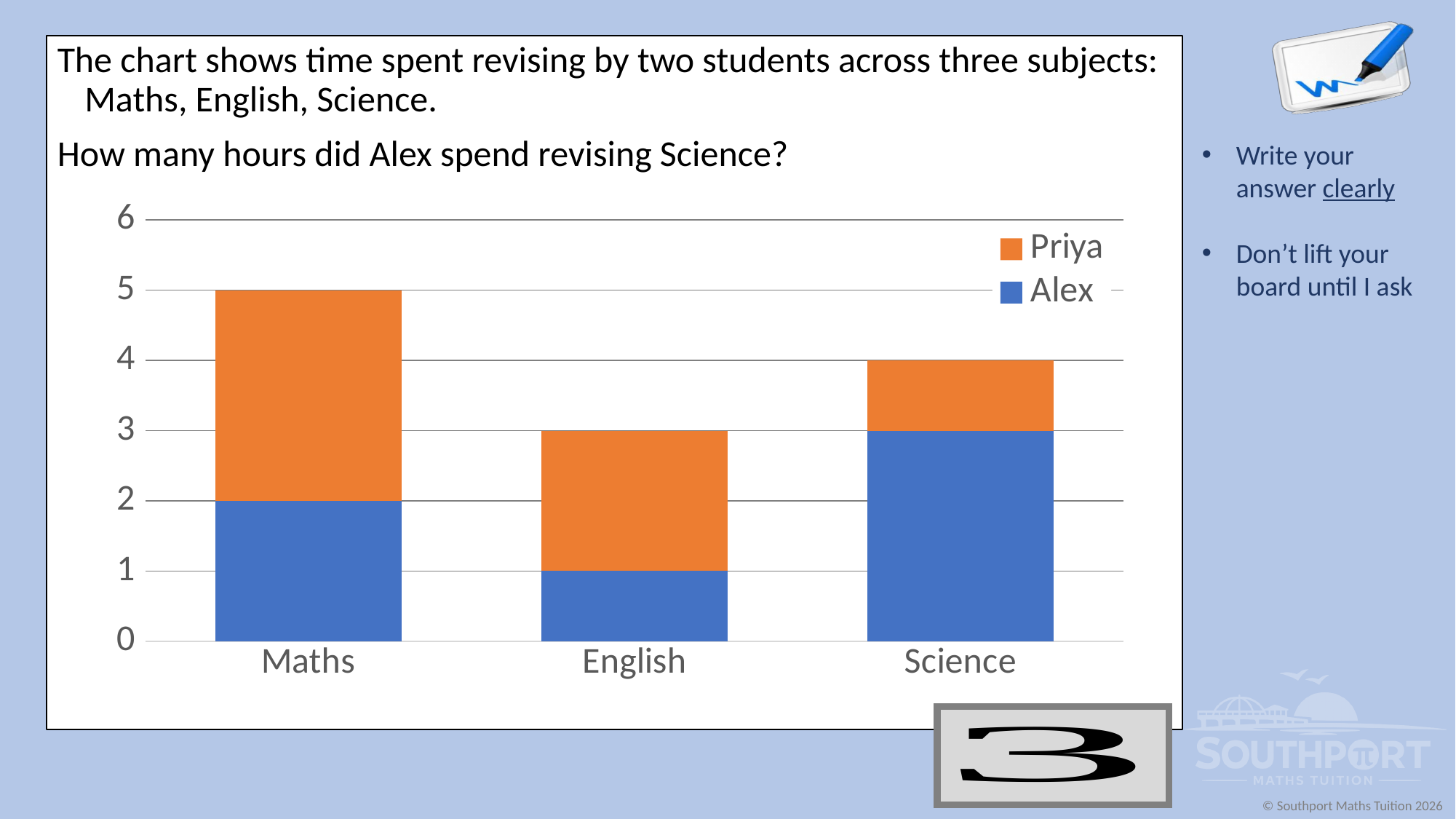
How many hours did Alex spend revising Science? 3 How many hours did Priya spend revising Maths? 3 What kind of chart is shown on the slide? stacked bar chart What is the total height of the stacked bar for English? 3 How many series does the legend list? 2 In which subject did Alex spend the fewest hours revising? English What is the total height of the stacked bar for Maths? 5 How many hours did Alex spend revising English? 1 In which subject did Alex spend the most hours revising? Science What is the total height of the stacked bar for Science? 4 How many hours did Alex spend revising Maths? 2 Which colour represents Priya in the chart? orange